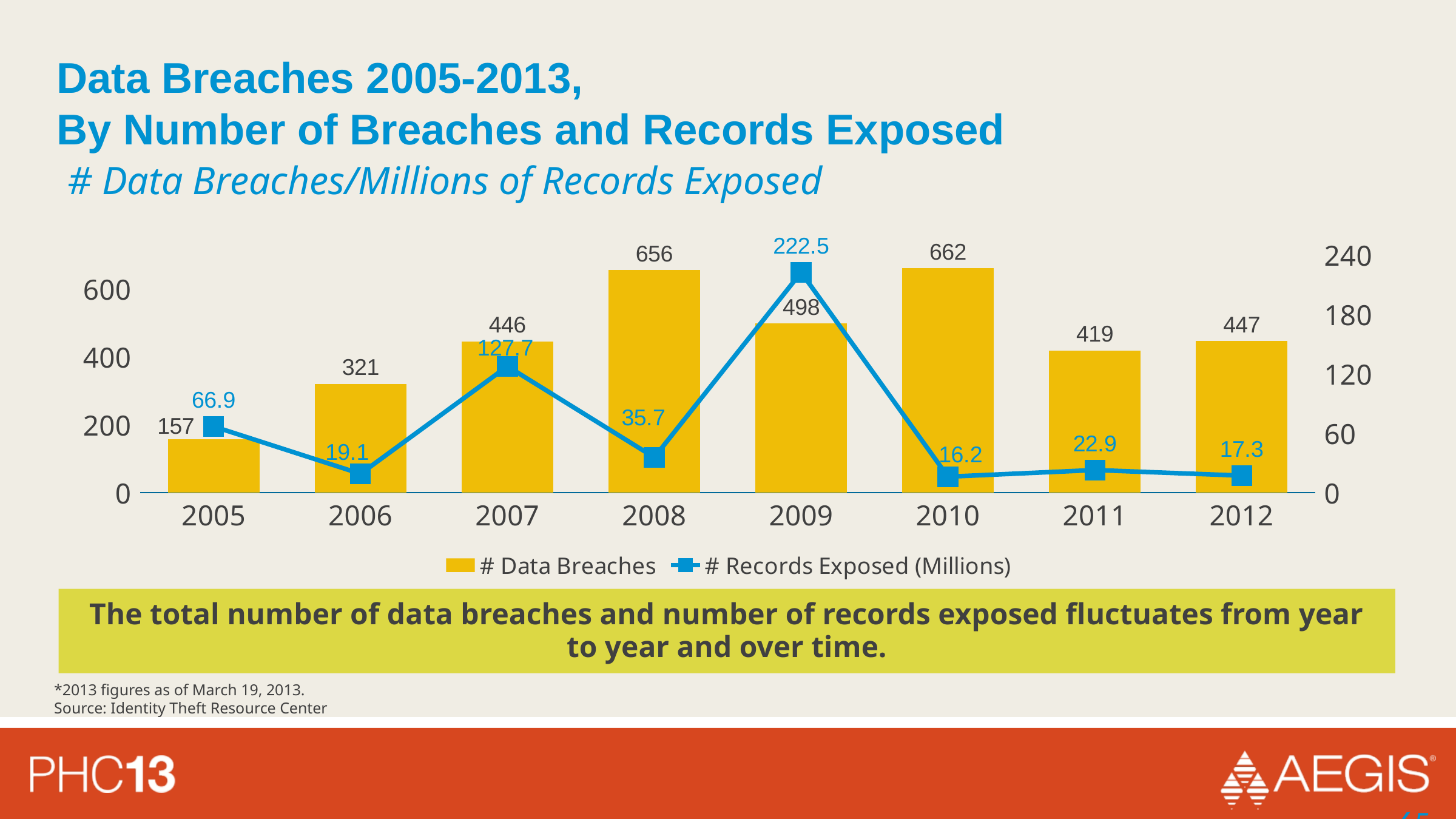
Were more records exposed in 2007 or in 2005? 2007 What is the difference in the number of data breaches between 2010 and 2009? 164 How many millions of records were exposed in 2009? 222.5 Which year had the lowest number of records exposed (millions)? 2010 What kind of chart is used to show the # Data Breaches series? Bar chart How many series does the legend list? 2 Which year had the lowest number of data breaches? 2005 How many years are shown on the x axis? 8 Which year had the highest number of data breaches? 2010 How many data breaches were there in 2008? 656 Did the number of data breaches rise or fall from 2005 to 2008? Rise Which year had more data breaches, 2007 or 2012? 2012